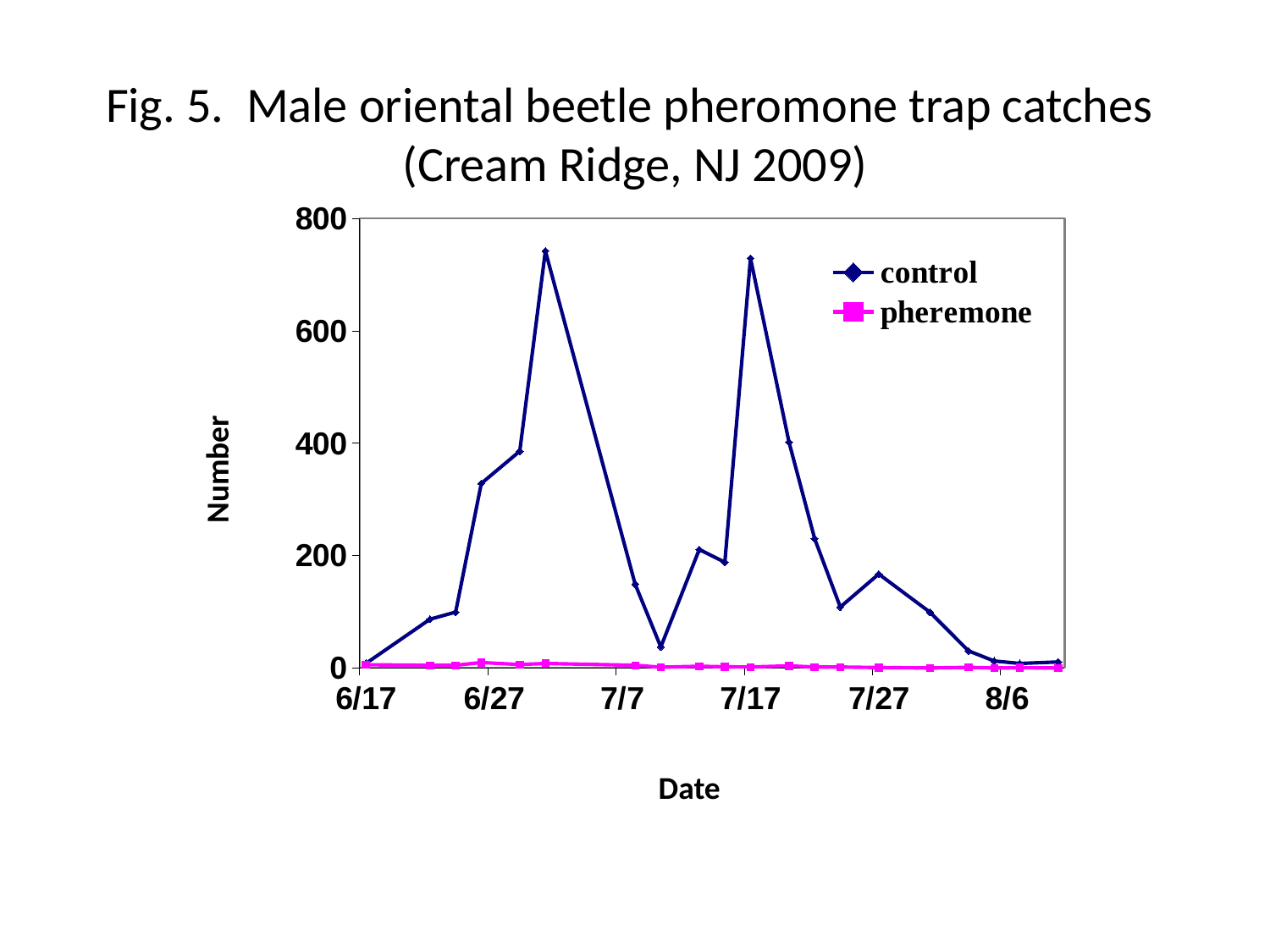
What are the two series named in the legend? control and pheremone Is the value for control on 7/17 greater or less than 600? greater How many series does the legend list? 2 What kind of chart is shown on the slide? line chart Which series reaches the highest value on the chart? control On 7/17, which series has the larger value, control or pheromone? control What is the label of the y axis? Number Is the value for control on 6/27 greater or less than 200? greater Do the control values rise or fall between 7/17 and 8/6? fall Is the value for pheromone on 7/17 greater or less than 200? less Which series stays lowest across all dates? pheremone